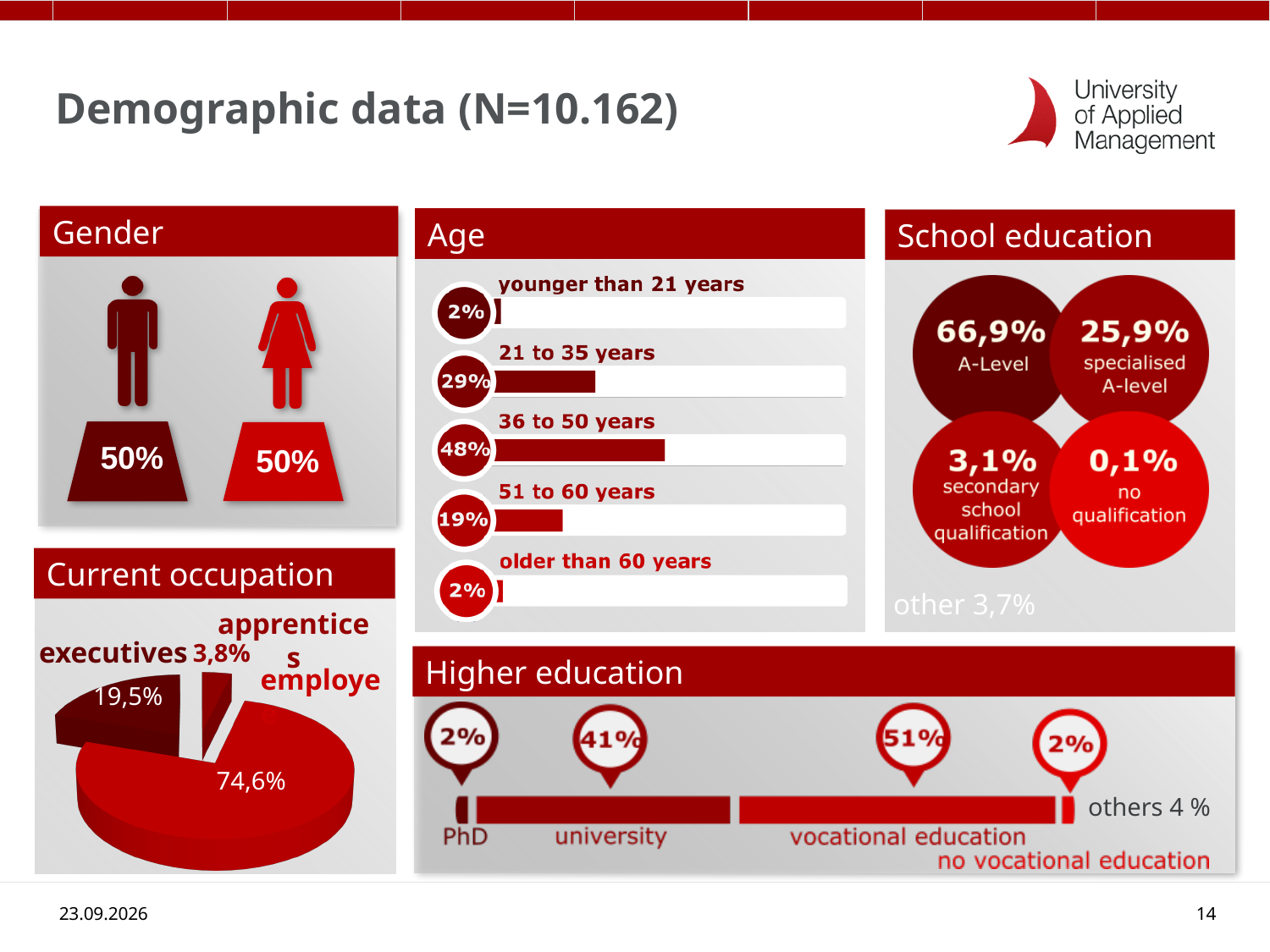
In the School education chart, what percentage of respondents have a specialised A-level? 25,9% In the School education chart, what is the difference between the A-Level share and the specialised A-level share? 41,0% In the Age chart, is the share for 21 to 35 years larger or smaller than the share for 51 to 60 years? larger In the Current occupation chart, which occupation group has the smallest share? apprentices In the Gender chart, what percentage of respondents are female? 50% In the Age chart, how many age groups are shown? 5 What kind of chart is used for Current occupation? pie chart In the Age chart, what percentage of respondents are 36 to 50 years old? 48% In the Higher education chart, what percentage of respondents have a vocational education? 51% In the Age chart, which age group has the largest share? 36 to 50 years In the Current occupation chart, what share of respondents are executives? 19,5% In the Age chart, what is the difference between the share of 21 to 35 years and the share of 51 to 60 years? 10%